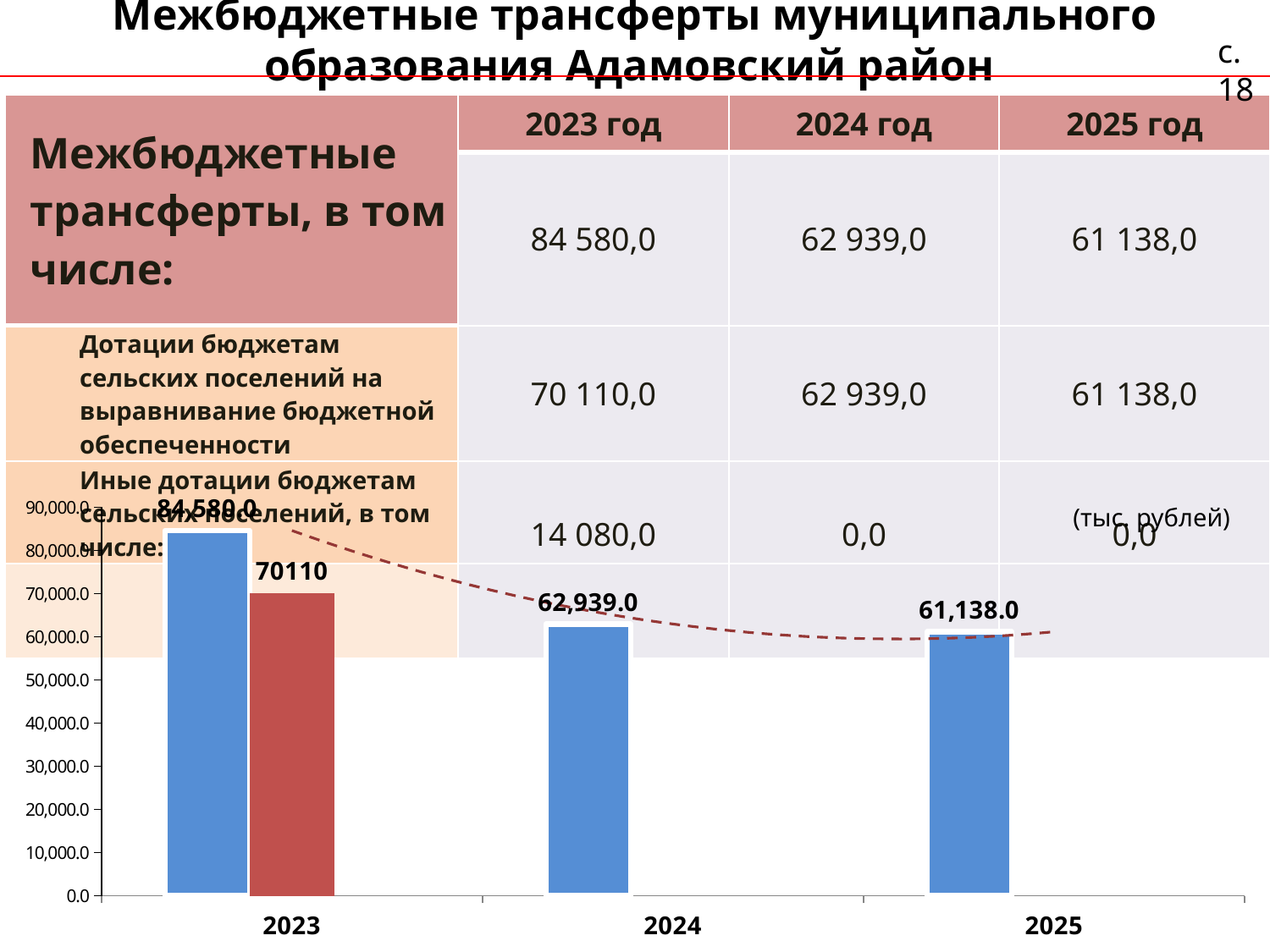
Which year has the lowest blue bar in the chart? 2025 Which year has the highest blue bar in the chart? 2023 What kind of chart is shown on the slide? Bar chart Do the blue bar values rise or fall from 2023 to 2025? Fall What is the value of the blue bar for 2023 in the chart? 84,580.0 For 2023, which bar is larger, the blue one or the red one? The blue one What is the difference between the blue bar and the red bar for 2023 in the chart? 14,470.0 What is the value of the red bar for 2023 in the chart? 70110 What is the difference between the 2024 value and the 2025 value in the chart? 1,801.0 How many years are shown on the x axis of the chart? 3 What is the value shown for 2025 in the chart? 61,138.0 What is the value shown for 2024 in the chart? 62,939.0